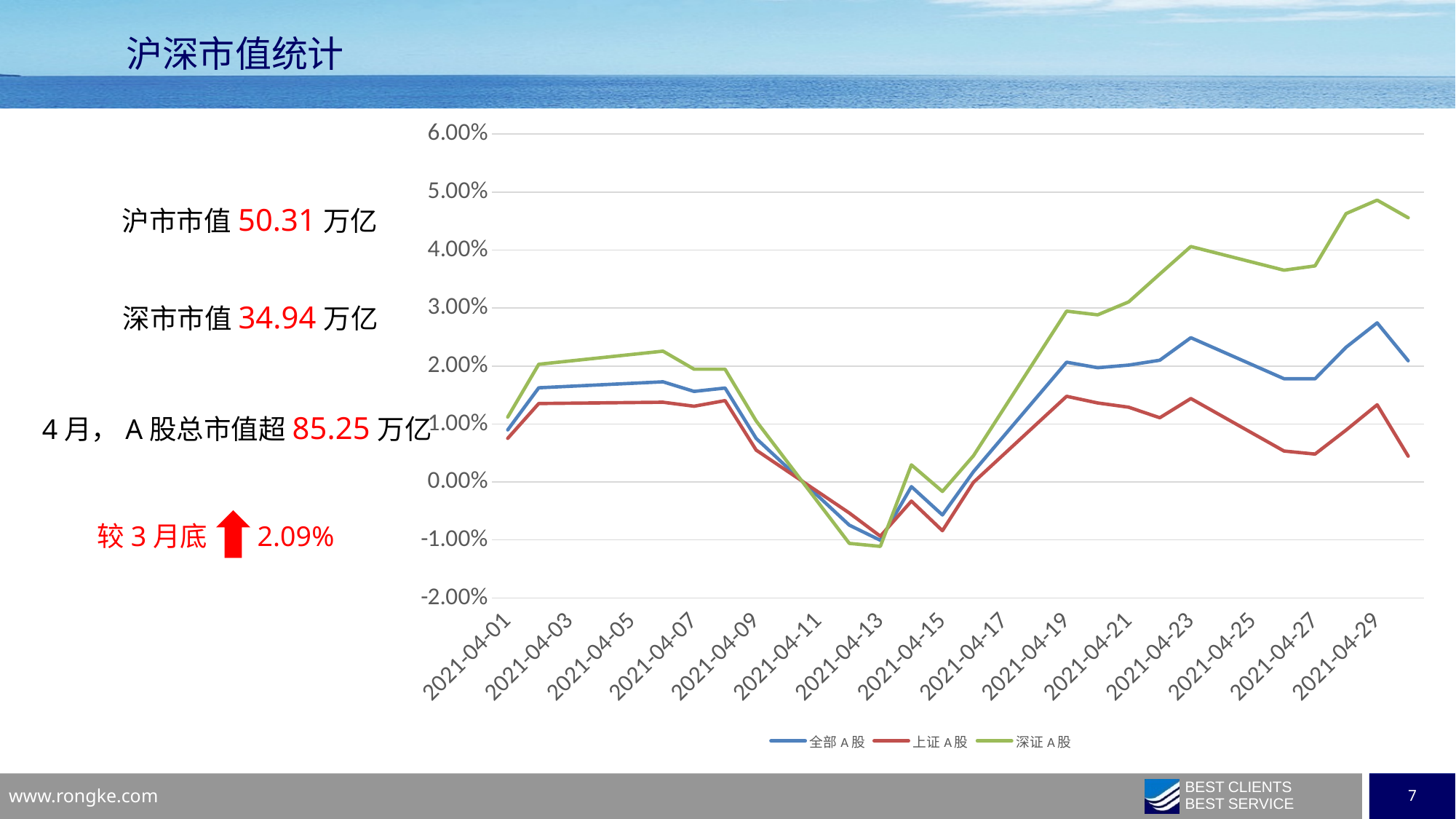
What kind of chart is shown on the slide? line chart Is the value for 全部A股 on 2021-04-13 greater or less than 0.00%? less Which series has the lowest value on 2021-04-23? 上证A股 Is the value for 深证A股 on 2021-04-29 greater or less than 4.00%? greater Which series reaches the highest value anywhere on the chart? 深证A股 On 2021-04-29, which series is higher, 全部A股 or 上证A股? 全部A股 Is the value for 上证A股 on 2021-04-29 greater or less than 2.00%? less How many series does the chart legend list? 3 Which colour is used for the 深证A股 line? green What are the three series named in the chart legend? 全部A股, 上证A股, 深证A股 Between 2021-04-15 and 2021-04-19, does the 深证A股 line rise or fall? rise